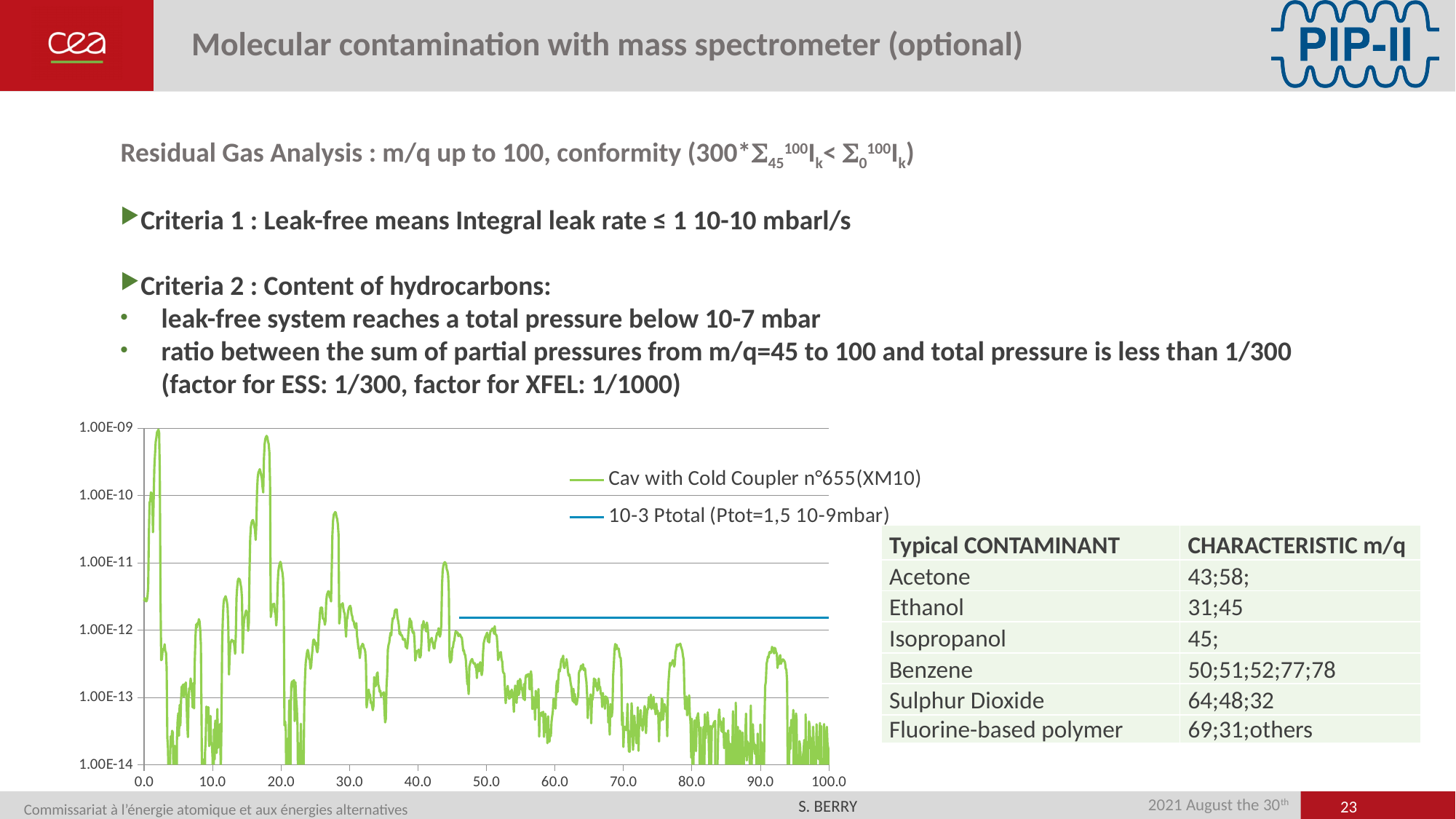
What is the lowest value shown on the chart's y axis? 1.00E-14 Is the horizontal blue line (10-3 Ptotal) greater or less than 1.00E-11? less How many tick labels are shown on the chart's x axis? 11 Is the horizontal blue line (10-3 Ptotal) greater or less than 1.00E-12? greater What is the name of the green series in the chart legend? Cav with Cold Coupler n°655(XM10) What is the maximum value shown on the chart's x axis? 100.0 What is the name of the blue series in the chart legend? 10-3 Ptotal (Ptot=1,5 10-9mbar) What is the highest value shown on the chart's y axis? 1.00E-09 Do the values of the green series generally rise or fall as m/q increases from 50.0 to 100.0? fall What kind of chart is shown on the slide? line chart How many series does the chart legend list? 2 Is the highest peak of the green series (near m/q 2) greater or less than 1.00E-10? greater